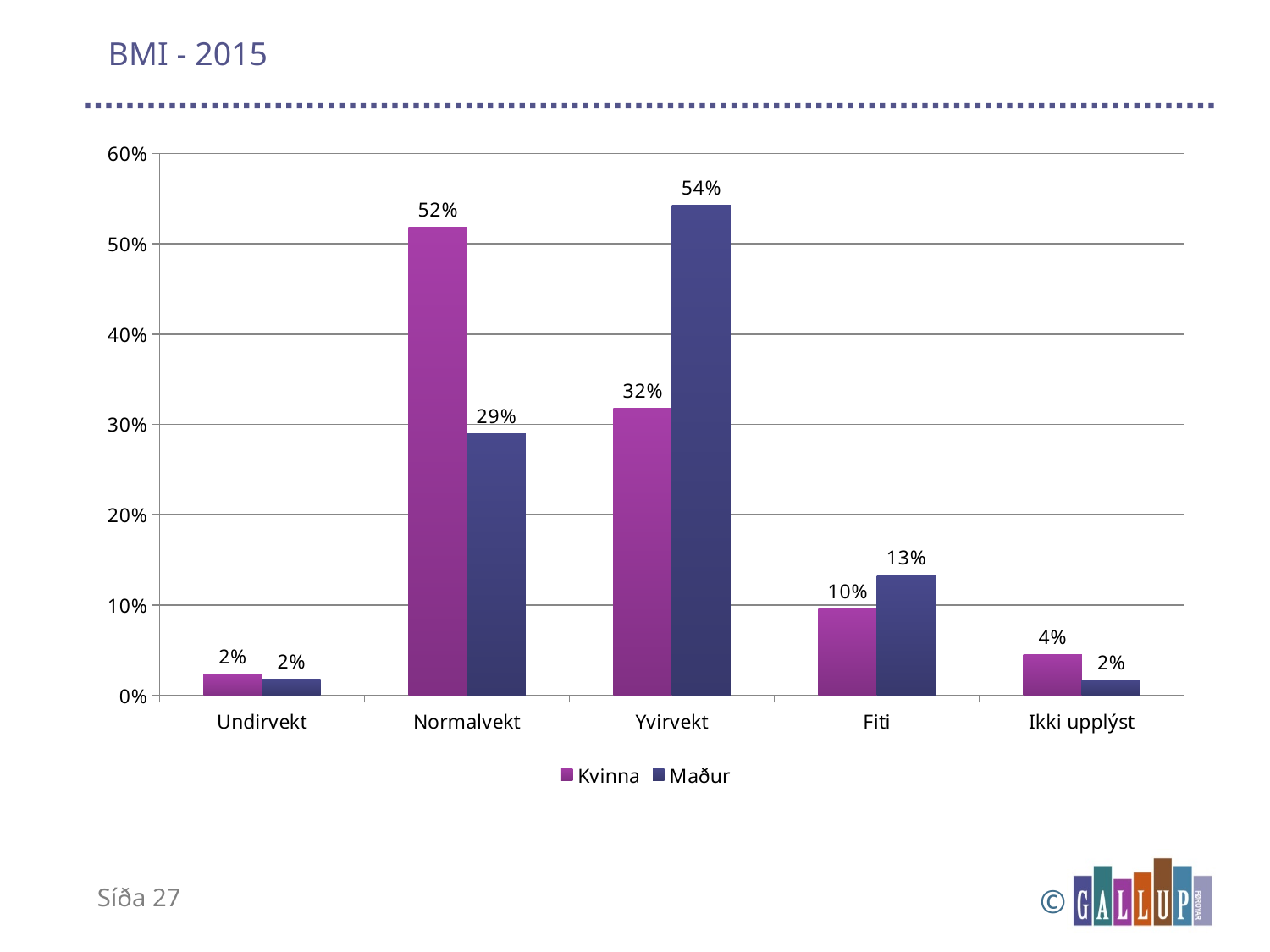
What is the value for Maður in the Yvirvekt category? 54% In the Yvirvekt category, which series has the larger value, Kvinna or Maður? Maður Which category has the highest value for the Maður series? Yvirvekt What is the title of the slide? BMI - 2015 What kind of chart is shown on the slide? Bar chart Which category has the highest value for the Kvinna series? Normalvekt What is the value for Kvinna in the Fiti category? 10% How many series does the legend list? 2 How many categories are shown on the x axis? 5 What is the value for Maður in the Normalvekt category? 29% What is the value for Kvinna in the Normalvekt category? 52% What is the difference between the Kvinna and Maður values in the Normalvekt category? 23%